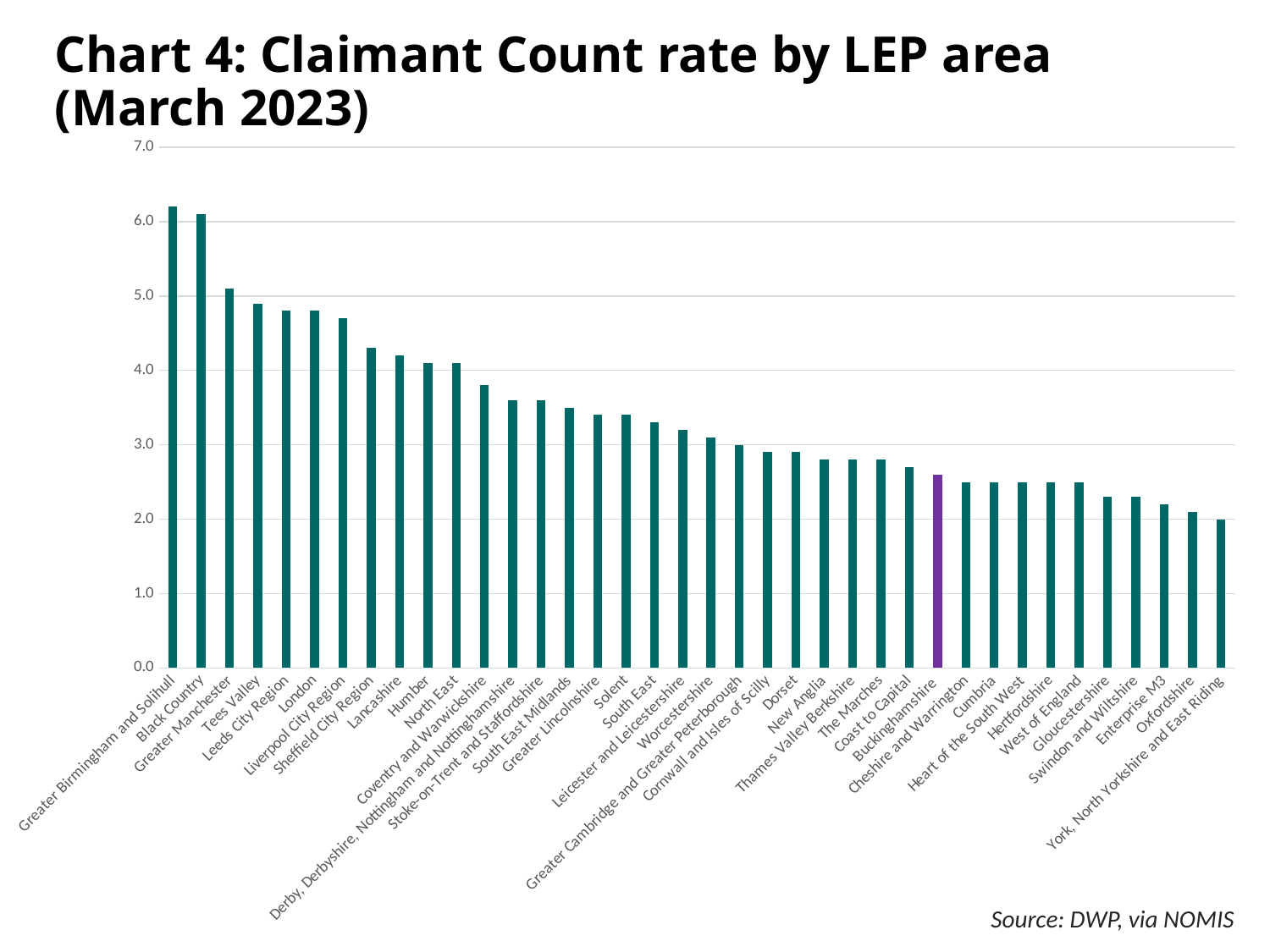
How many LEP areas are plotted in the chart? 38 Is the value for Cumbria greater or less than 3.0? less Which has the higher Claimant Count rate, London or Solent? London Is the value for Lancashire greater or less than 4.0? greater Do the values rise or fall moving from left to right along the x axis? fall Is the value for Buckinghamshire greater or less than 3.0? less Which has the higher Claimant Count rate, Black Country or Cumbria? Black Country Which LEP area's bar is shown in a different colour (purple) from the others? Buckinghamshire Which LEP area has the highest Claimant Count rate? Greater Birmingham and Solihull What kind of chart is shown on the slide? bar chart